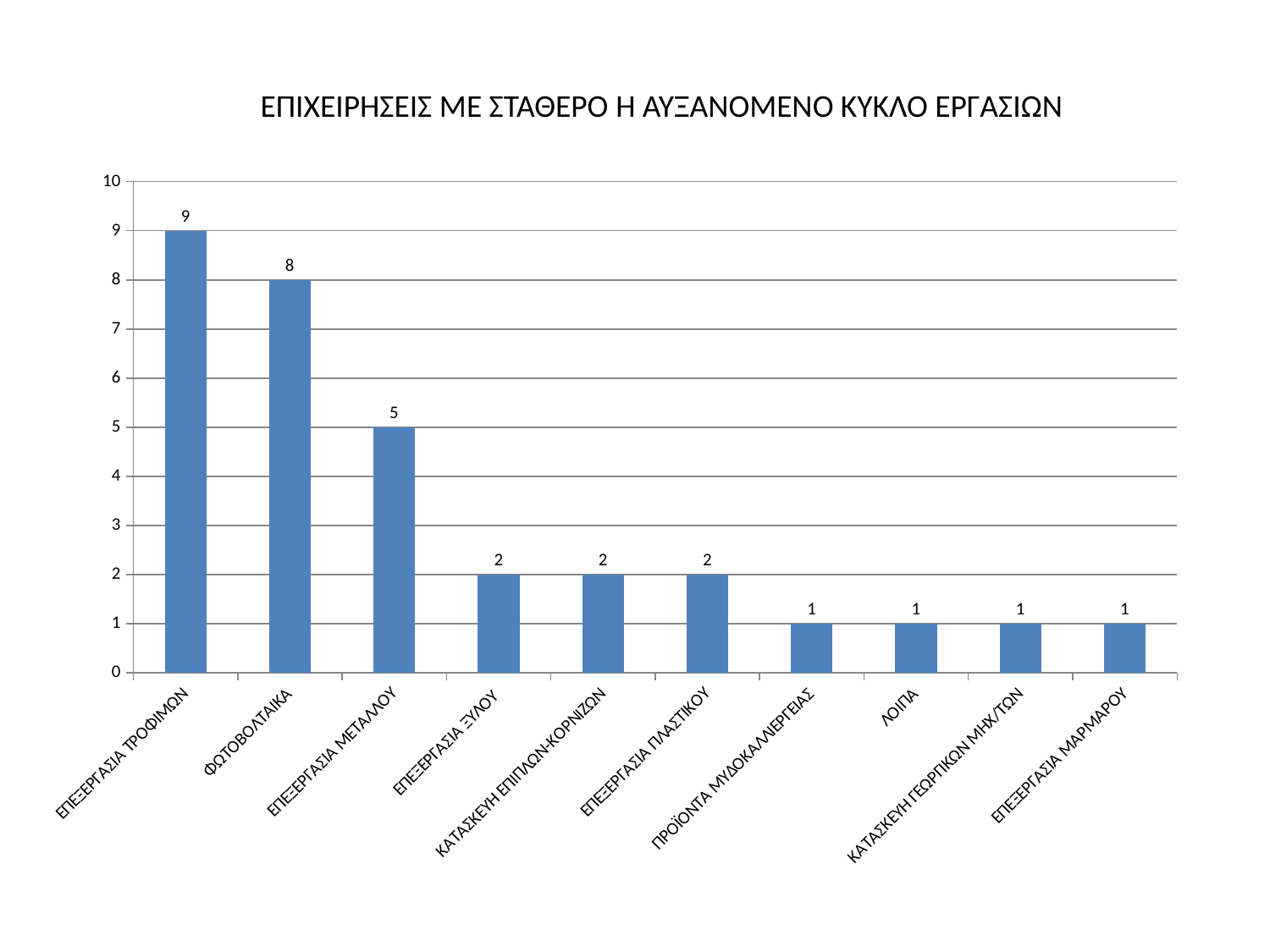
What is the value for ΚΑΤΑΣΚΕΥΗ ΕΠΙΠΛΩΝ-ΚΟΡΝΙΖΩΝ? 2 What is the value for ΦΩΤΟΒΟΛΤΑΙΚΑ? 8 How many categories are shown on the x axis? 10 What is the value for ΛΟΙΠΑ? 1 What is the difference between the values for ΕΠΕΞΕΡΓΑΣΙΑ ΤΡΟΦΙΜΩΝ and ΕΠΕΞΕΡΓΑΣΙΑ ΜΕΤΑΛΛΟΥ? 4 What is the value for ΕΠΕΞΕΡΓΑΣΙΑ ΤΡΟΦΙΜΩΝ? 9 Which category has the highest value? ΕΠΕΞΕΡΓΑΣΙΑ ΤΡΟΦΙΜΩΝ What is the value for ΕΠΕΞΕΡΓΑΣΙΑ ΜΕΤΑΛΛΟΥ? 5 Which is larger, the value for ΦΩΤΟΒΟΛΤΑΙΚΑ or the value for ΕΠΕΞΕΡΓΑΣΙΑ ΞΥΛΟΥ? ΦΩΤΟΒΟΛΤΑΙΚΑ Do the values rise or fall from left to right along the x axis? fall What is the title of the chart? ΕΠΙΧΕΙΡΗΣΕΙΣ ΜΕ ΣΤΑΘΕΡΟ Η ΑΥΞΑΝΟΜΕΝΟ ΚΥΚΛΟ ΕΡΓΑΣΙΩΝ What kind of chart is shown on the slide? bar chart